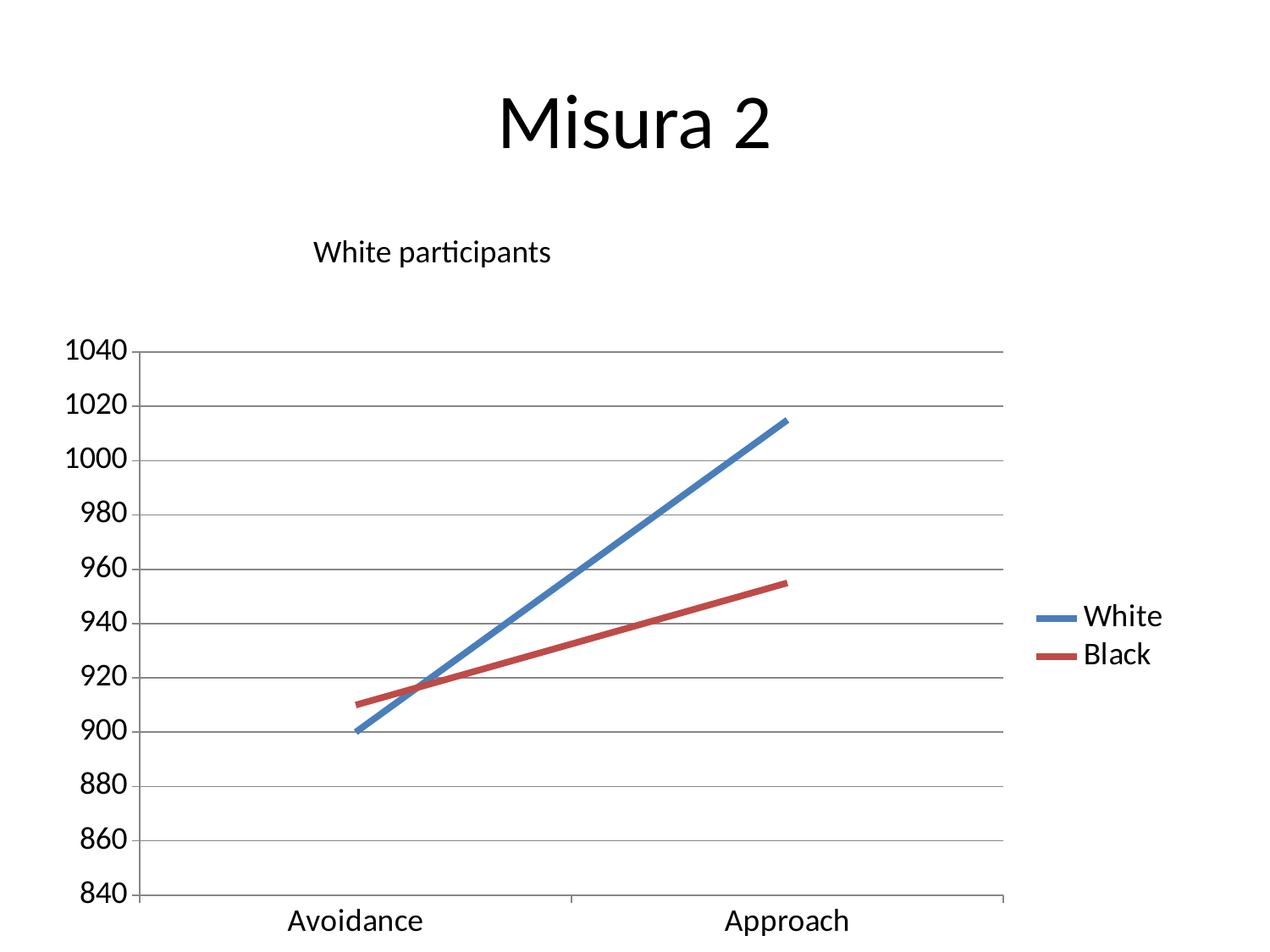
Does the White series rise or fall from Avoidance to Approach? rise What are the two categories on the x axis? Avoidance and Approach Does the Black series rise or fall from Avoidance to Approach? rise How many categories are shown on the x axis? 2 What is the title of the chart? White participants Is the value for Black at Avoidance greater or less than 920? less Is the value for Black at Approach greater or less than 960? less What kind of chart is shown on the slide? line chart Is the value for White at Approach greater or less than 1000? greater Which series has the higher value at Approach, White or Black? White How many series does the legend list? 2